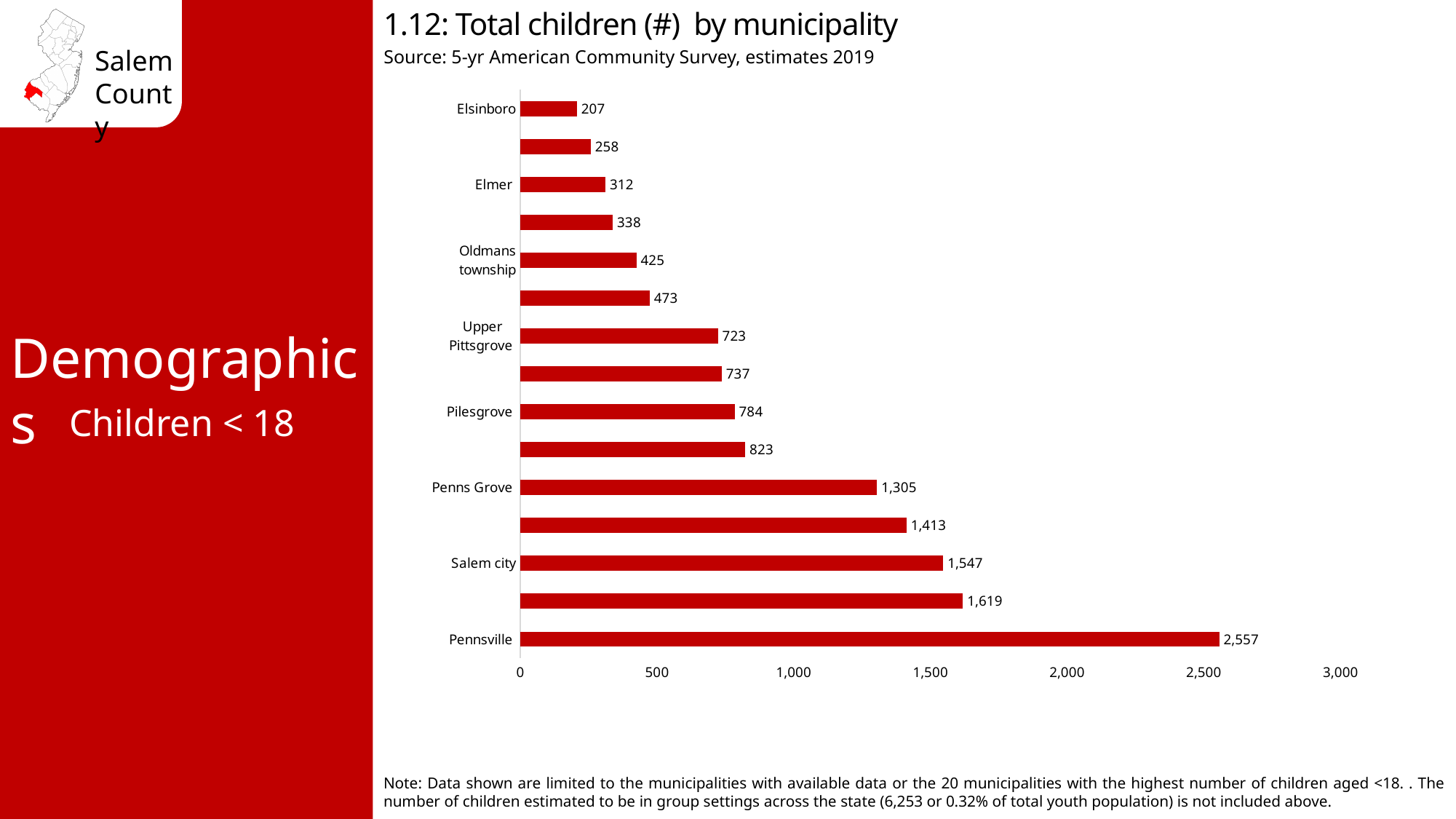
What is the value for Oldmans township? 425 How many children are shown for Pennsville? 2,557 Which municipality has the lowest number of children? Elsinboro What is the value for Penns Grove? 1,305 What is the title of the chart? 1.12: Total children (#) by municipality What type of chart is shown on the slide? Bar chart Which has more children, Upper Pittsgrove or Pilesgrove? Pilesgrove Which municipality has the highest number of children? Pennsville How many bars are plotted in the chart? 15 What is the difference between the values for Pennsville and Salem city? 1,010 What is the value for Salem city? 1,547 Is the value for Elmer greater or less than 500? less